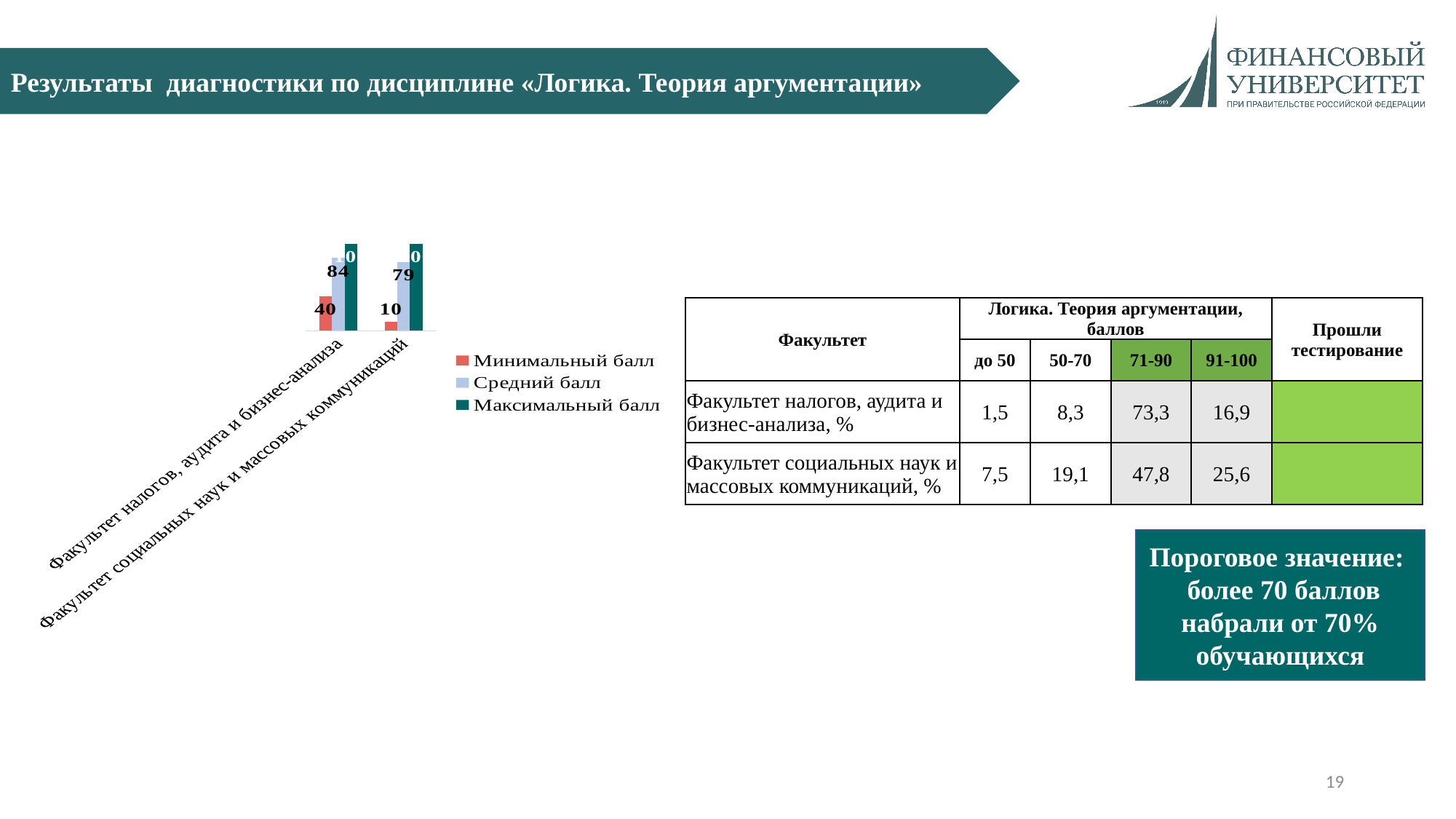
What type of chart is shown on the slide? bar chart Which faculty has the lower Средний балл? Факультет социальных наук и массовых коммуникаций Which series is shown in red in the chart legend? Минимальный балл What is the value of Минимальный балл for Факультет социальных наук и массовых коммуникаций? 10 How many series does the chart legend list? 3 What is the value of Средний балл for Факультет социальных наук и массовых коммуникаций? 79 What is the difference between the Минимальный балл values of the two faculties? 30 What is the value of Минимальный балл for Факультет налогов, аудита и бизнес-анализа? 40 What is the value of Средний балл for Факультет налогов, аудита и бизнес-анализа? 84 How many faculties (categories) are shown on the chart? 2 What is the difference between the Средний балл values of the two faculties? 5 Which faculty has the higher Минимальный балл? Факультет налогов, аудита и бизнес-анализа